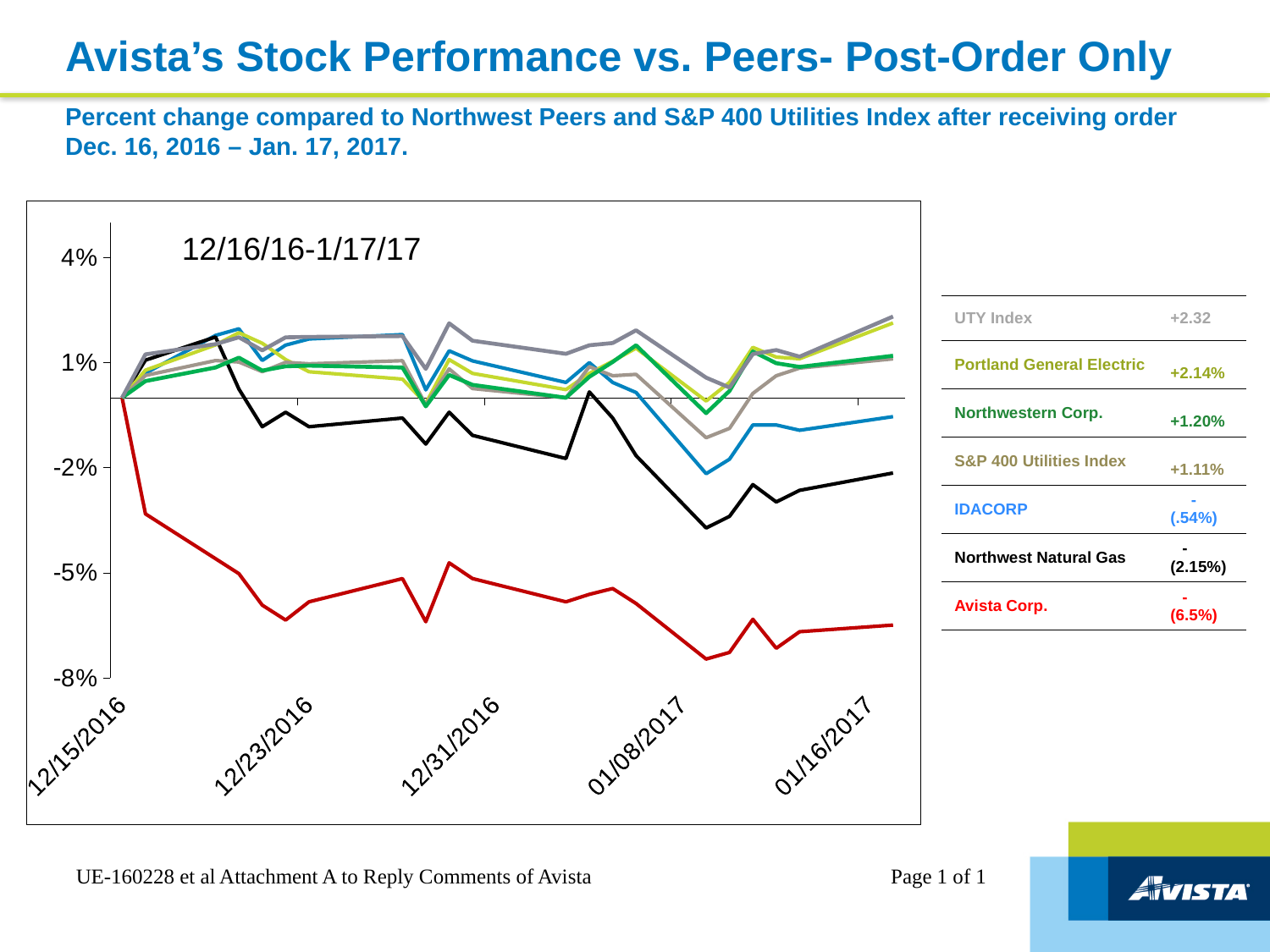
Which series has the lowest percent change in the legend table? Avista Corp. Which series has the highest percent change in the legend table? UTY Index What colour is the Avista Corp. line in the chart? red According to the legend table, what is the percent change for Northwest Natural Gas? -(2.15%) Does the Avista Corp. line rise or fall from 12/15/2016 to 01/16/2017? fall Is the Avista Corp. line at 01/08/2017 greater or less than -5%? less Which has the larger percent change in the legend table, Northwestern Corp. or IDACORP? Northwestern Corp. According to the legend table, what is the percent change for the S&P 400 Utilities Index? +1.11% How many series does the legend on the right of the chart list? 7 According to the legend table, what is the percent change for Avista Corp.? -(6.5%) According to the legend table, what is the percent change for Portland General Electric? +2.14% What kind of chart is shown on the slide? line chart